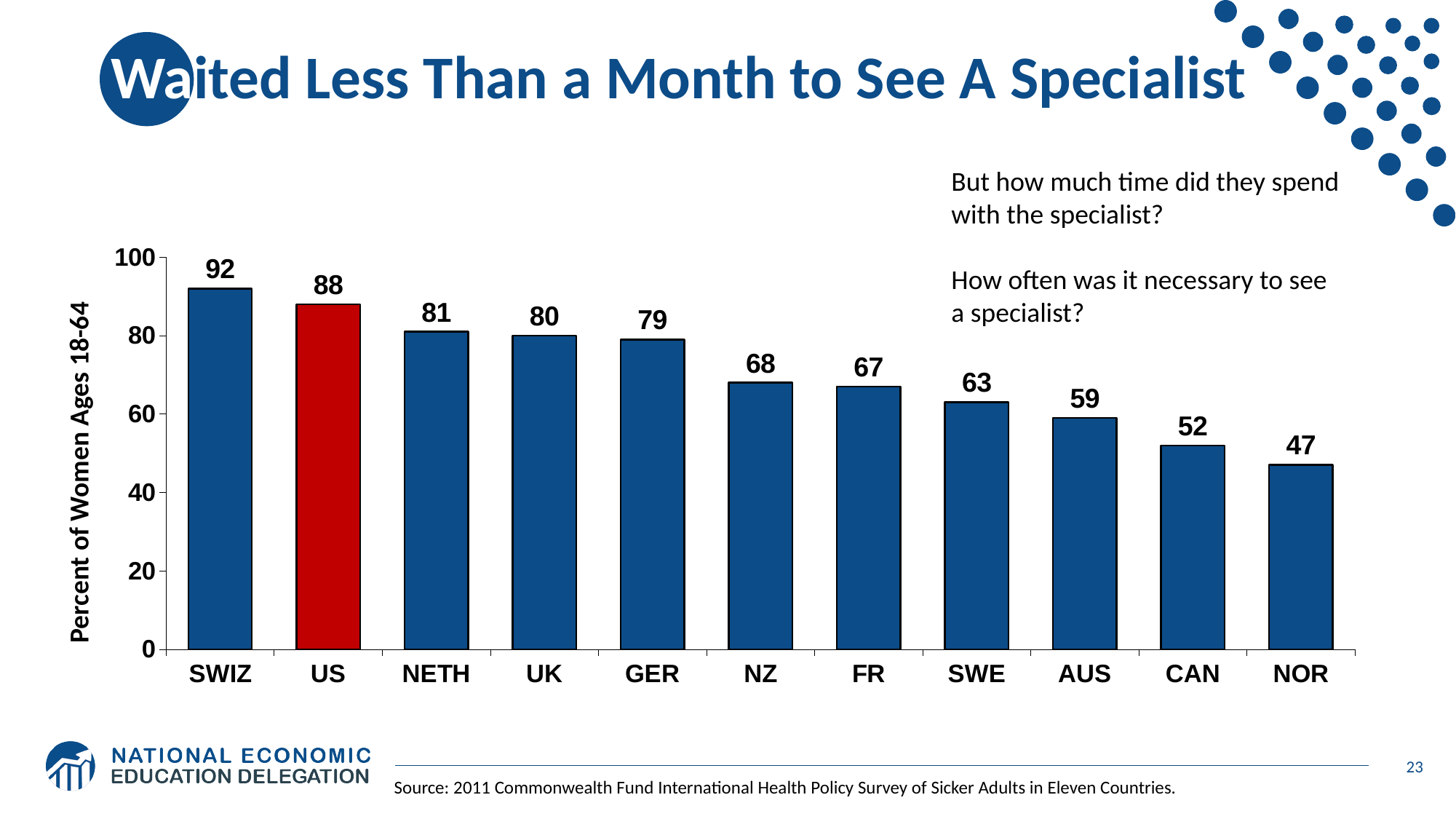
What is the difference between the values for SWIZ and the US? 4 What is the value for NOR? 47 What is the difference between the values for CAN and NOR? 5 What is the value for GER? 79 Is the value for AUS greater or less than 60? less Which country's bar is coloured red? US How many countries are shown on the chart? 11 What is the value for the US? 88 Which country has the lowest value? NOR Which country has the highest value? SWIZ Which is larger, the value for NZ or the value for SWE? NZ What kind of chart is shown on the slide? bar chart